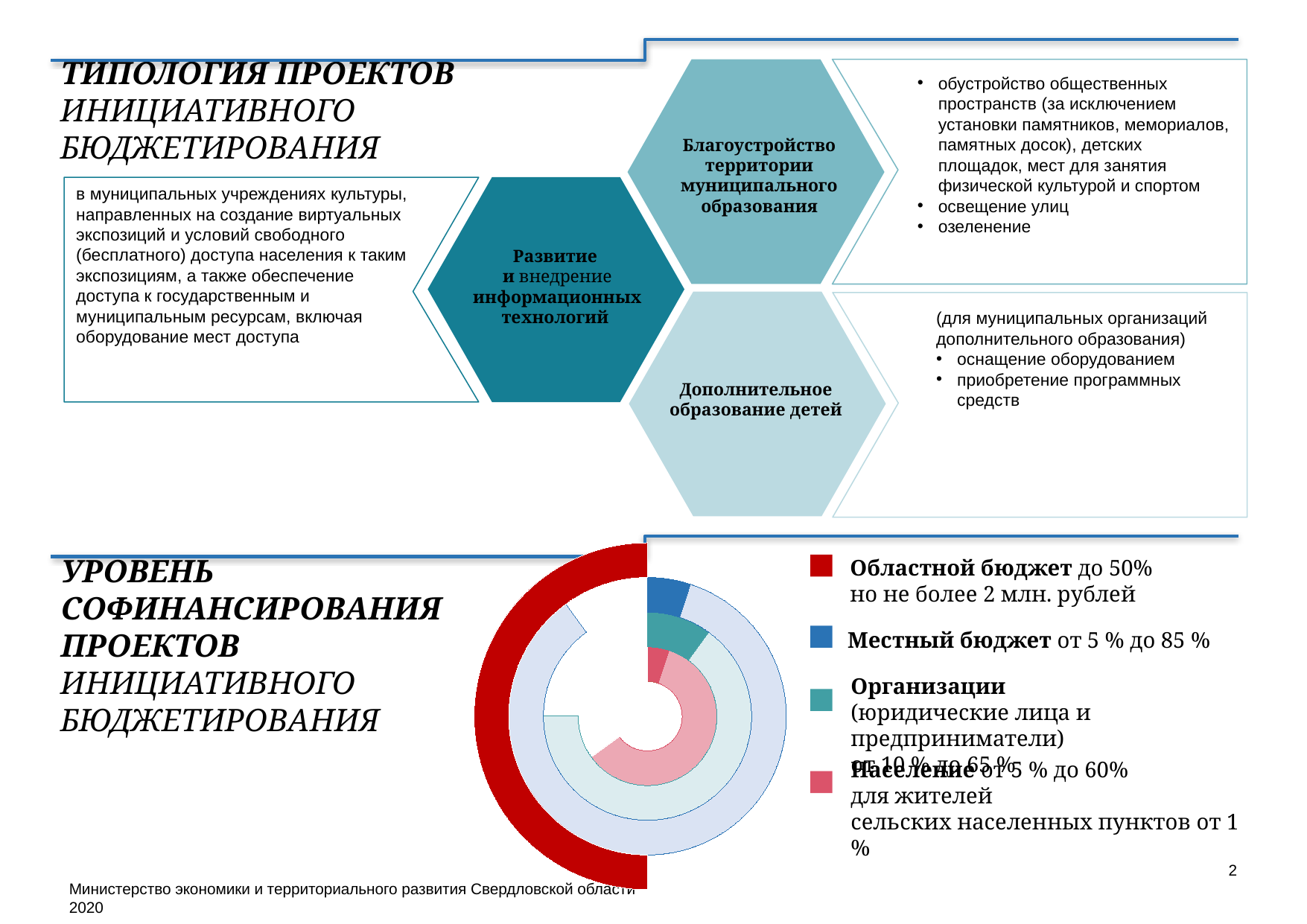
According to the legend of the co-financing chart, what is the monetary cap on the regional budget contribution? не более 2 млн. рублей According to the legend of the co-financing chart, what is the range for 'Местный бюджет'? от 5 % до 85 % According to the legend of the co-financing chart, what is the range for 'Организации'? от 10 % до 65 % According to the legend of the co-financing chart, which has a higher maximum share: 'Организации' or 'Население'? Организации In the co-financing chart, which funding source is shown in blue? Местный бюджет How many funding sources does the legend of the co-financing chart list? 4 In the co-financing chart, which colour represents 'Областной бюджет'? Red According to the legend of the co-financing chart, what is the minimum share for residents of rural settlements ('сельских населенных пунктов')? от 1 % According to the legend of the co-financing chart, what is the maximum share for 'Областной бюджет'? до 50% According to the legend of the co-financing chart, what is the range for 'Население'? от 5 % до 60% What kind of chart is shown in the lower part of the slide under the heading 'УРОВЕНЬ СОФИНАНСИРОВАНИЯ ПРОЕКТОВ'? Doughnut chart According to the legend of the co-financing chart, which funding source has the highest maximum share? Местный бюджет